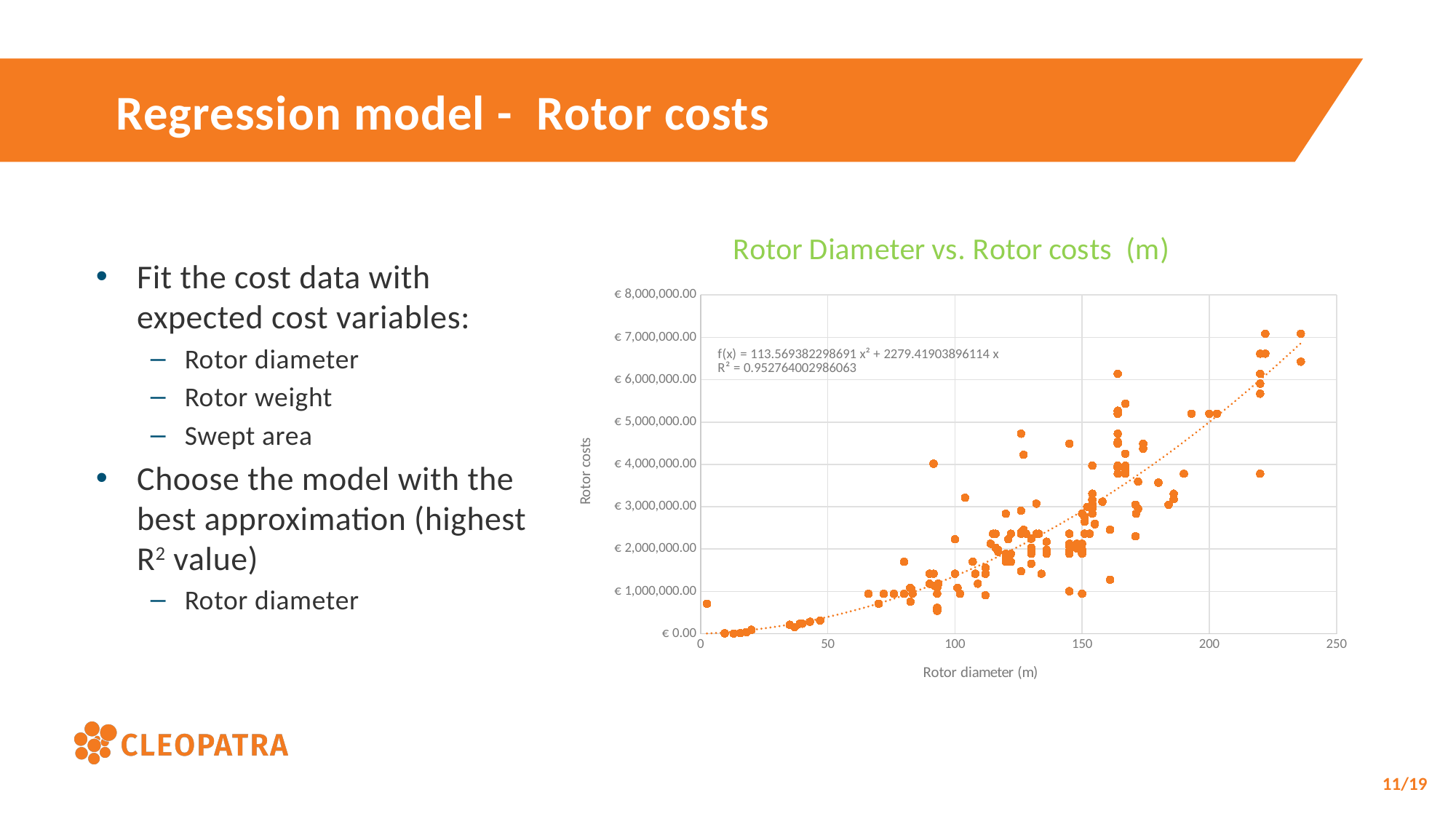
Is the rotor cost for the point at a rotor diameter of about 3 m greater or less than € 1,000,000.00? less What is the coefficient of x² in the trendline equation printed on the chart? 113.569382298691 What is the highest value shown on the horizontal axis of the chart? 250 What is the label of the horizontal axis of the chart? Rotor diameter (m) What is the coefficient of x in the trendline equation printed on the chart? 2279.41903896114 Is the rotor cost for the lowest point at a rotor diameter of about 220 m greater or less than € 4,000,000.00? less Do rotor costs generally rise or fall as rotor diameter increases along the x axis? rise What kind of chart is shown on the slide? scatter chart What is the title of the chart? Rotor Diameter vs. Rotor costs (m) Are any points on the chart plotted above € 8,000,000.00? No What is the highest value shown on the vertical axis of the chart? € 8,000,000.00 What R² value is printed on the chart for the fitted trendline? 0.952764002986063